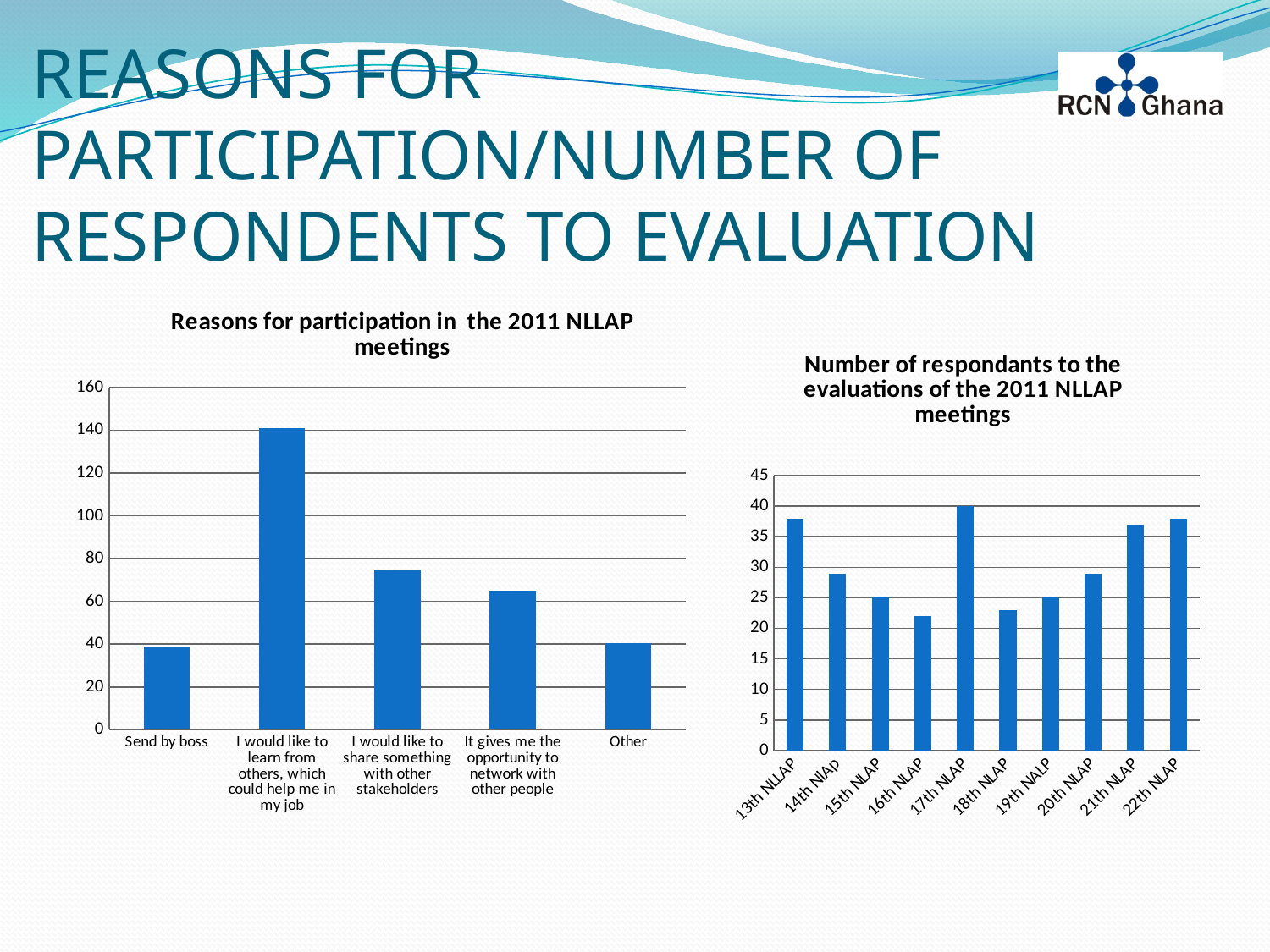
In the right chart, 'Number of respondants to the evaluations of the 2011 NLLAP meetings', is the value for 21th NLLAP greater or less than 35? greater In the left chart, 'Reasons for participation in the 2011 NLLAP meetings', which reason has the highest value? I would like to learn from others, which could help me in my job In the left chart, 'Reasons for participation in the 2011 NLLAP meetings', how many reasons are shown on the x axis? 5 In the left chart, 'Reasons for participation in the 2011 NLLAP meetings', which is larger: 'I would like to share something with other stakeholders' or 'It gives me the opportunity to network with other people'? I would like to share something with other stakeholders In the right chart, 'Number of respondants to the evaluations of the 2011 NLLAP meetings', which is larger: 13th NLLAP or 14th NLLAP? 13th NLLAP What is the title of the chart on the right side of the slide? Number of respondants to the evaluations of the 2011 NLLAP meetings What kind of chart is the left chart, 'Reasons for participation in the 2011 NLLAP meetings'? Bar chart In the left chart, 'Reasons for participation in the 2011 NLLAP meetings', is the value for 'I would like to learn from others, which could help me in my job' greater or less than 120? greater In the left chart, 'Reasons for participation in the 2011 NLLAP meetings', is the value for 'Send by boss' greater or less than 60? less In the right chart, 'Number of respondants to the evaluations of the 2011 NLLAP meetings', how many meetings are shown on the x axis? 10